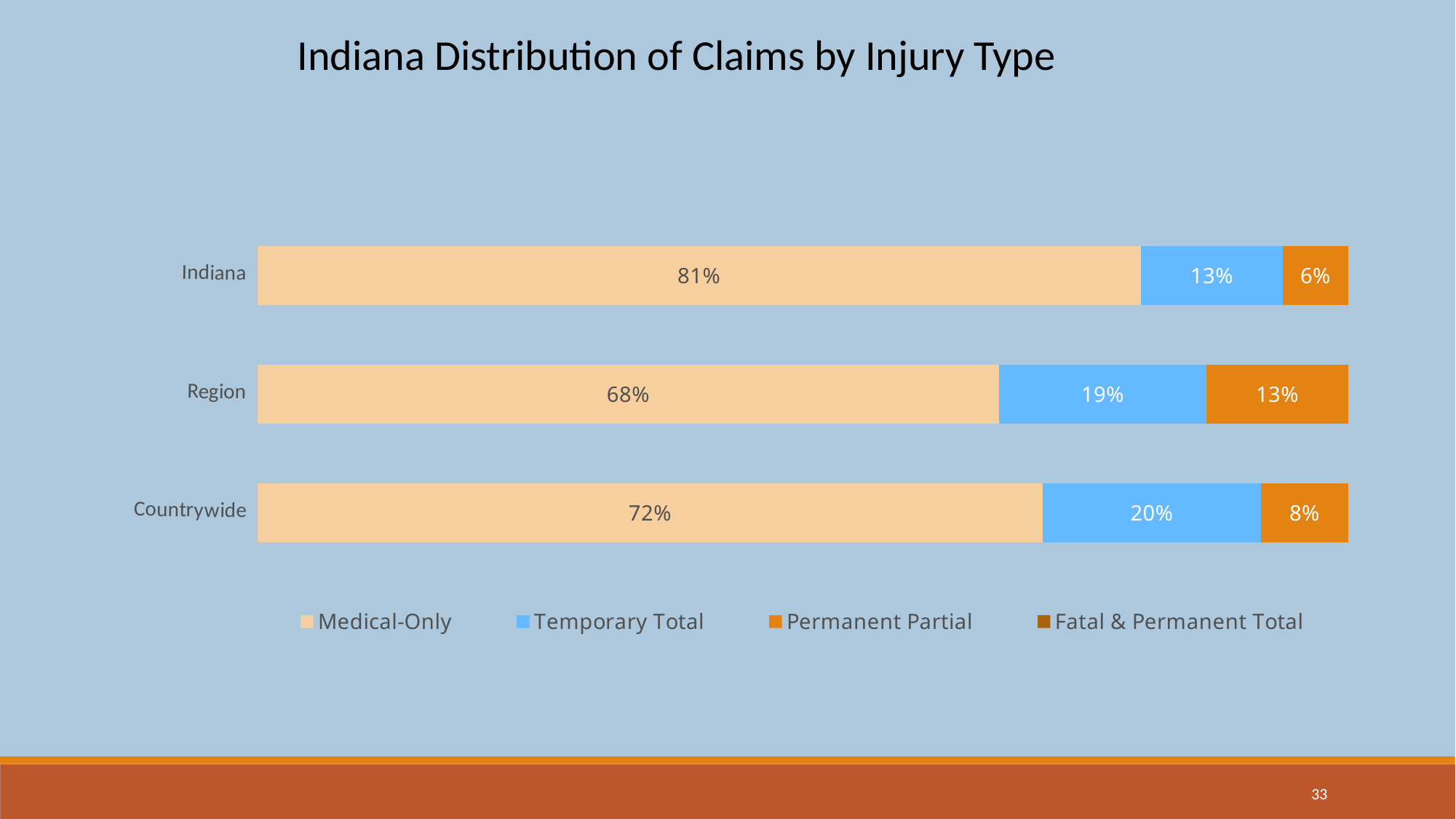
What is the difference between the Temporary Total share for Countrywide and for Indiana? 7 percentage points What is the Medical-Only share for Indiana? 81% How many categories are shown on the chart? 3 How many series does the legend list? 4 Which category has the highest Medical-Only share? Indiana What is the Permanent Partial share for Countrywide? 8% Which has a larger Temporary Total share, Countrywide or Indiana? Countrywide What is the Permanent Partial share for Region? 13% How much larger is the Medical-Only share for Indiana than for Region? 13 percentage points Which category has the lowest Permanent Partial share? Indiana What is the Temporary Total share for Region? 19% What kind of chart is shown on the slide? Stacked bar chart